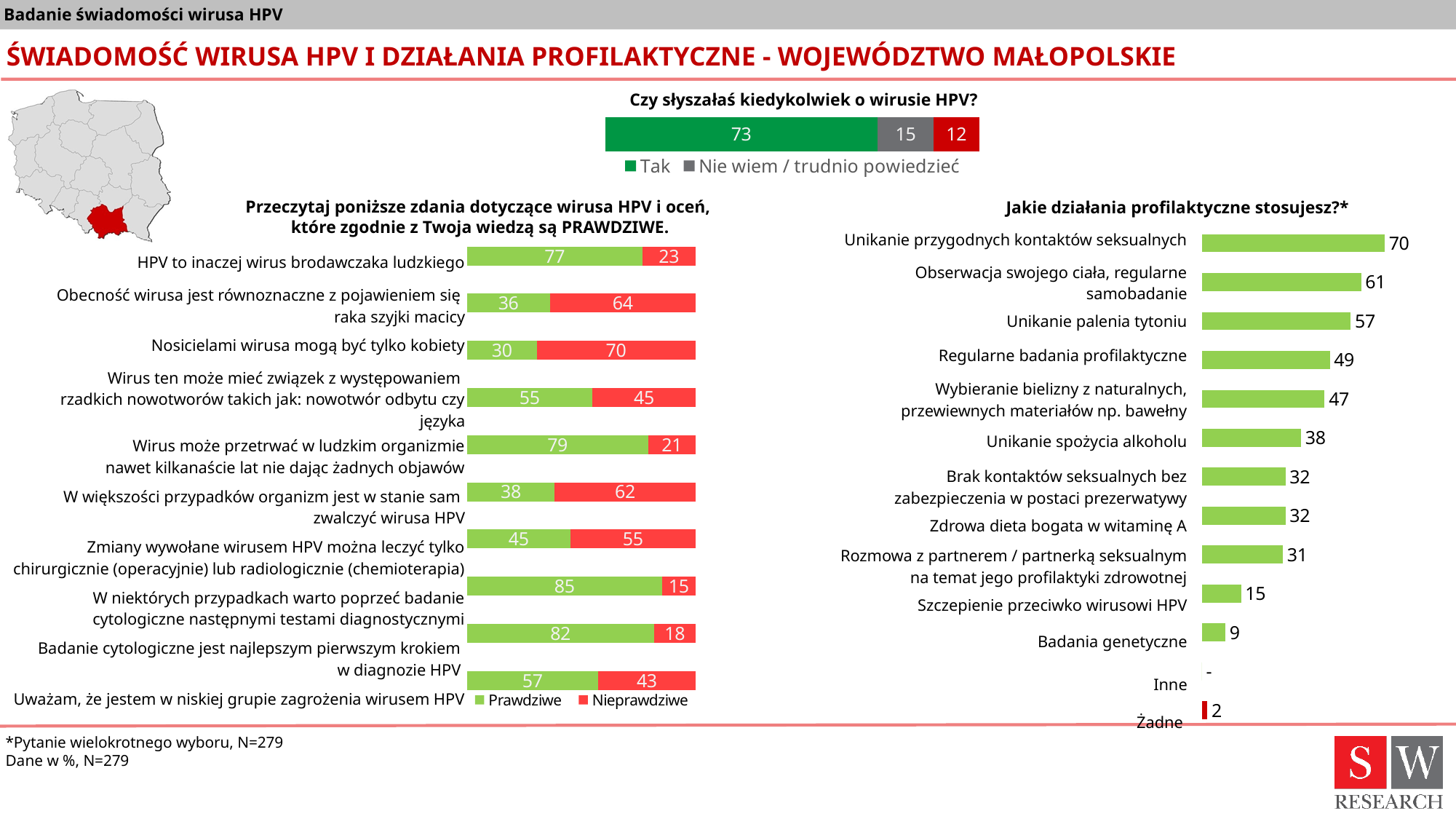
In the chart 'Czy słyszałaś kiedykolwiek o wirusie HPV?', what is the value for 'Tak'? 73 In the chart 'Przeczytaj poniższe zdania dotyczące wirusa HPV...', what is the 'Prawdziwe' value for 'HPV to inaczej wirus brodawczaka ludzkiego'? 77 In the chart 'Jakie działania profilaktyczne stosujesz?', which category has the highest value? Unikanie przygodnych kontaktów seksualnych In the chart 'Jakie działania profilaktyczne stosujesz?', what is the difference between 'Unikanie palenia tytoniu' and 'Unikanie spożycia alkoholu'? 19 How many series does the legend list in the chart 'Przeczytaj poniższe zdania dotyczące wirusa HPV...'? 2 In the chart 'Jakie działania profilaktyczne stosujesz?', which is larger: 'Regularne badania profilaktyczne' or 'Badania genetyczne'? Regularne badania profilaktyczne How many categories are shown in the chart 'Jakie działania profilaktyczne stosujesz?'? 13 In the chart 'Jakie działania profilaktyczne stosujesz?', what is the value for 'Szczepienie przeciwko wirusowi HPV'? 15 In the chart 'Czy słyszałaś kiedykolwiek o wirusie HPV?', what is the value for 'Nie wiem / trudno powiedzieć'? 15 In the chart 'Przeczytaj poniższe zdania dotyczące wirusa HPV...', what is the 'Nieprawdziwe' value for 'Nosicielami wirusa mogą być tylko kobiety'? 70 What type of chart is 'Jakie działania profilaktyczne stosujesz?'? bar chart In the chart 'Przeczytaj poniższe zdania dotyczące wirusa HPV...', what colour represents 'Nieprawdziwe'? red